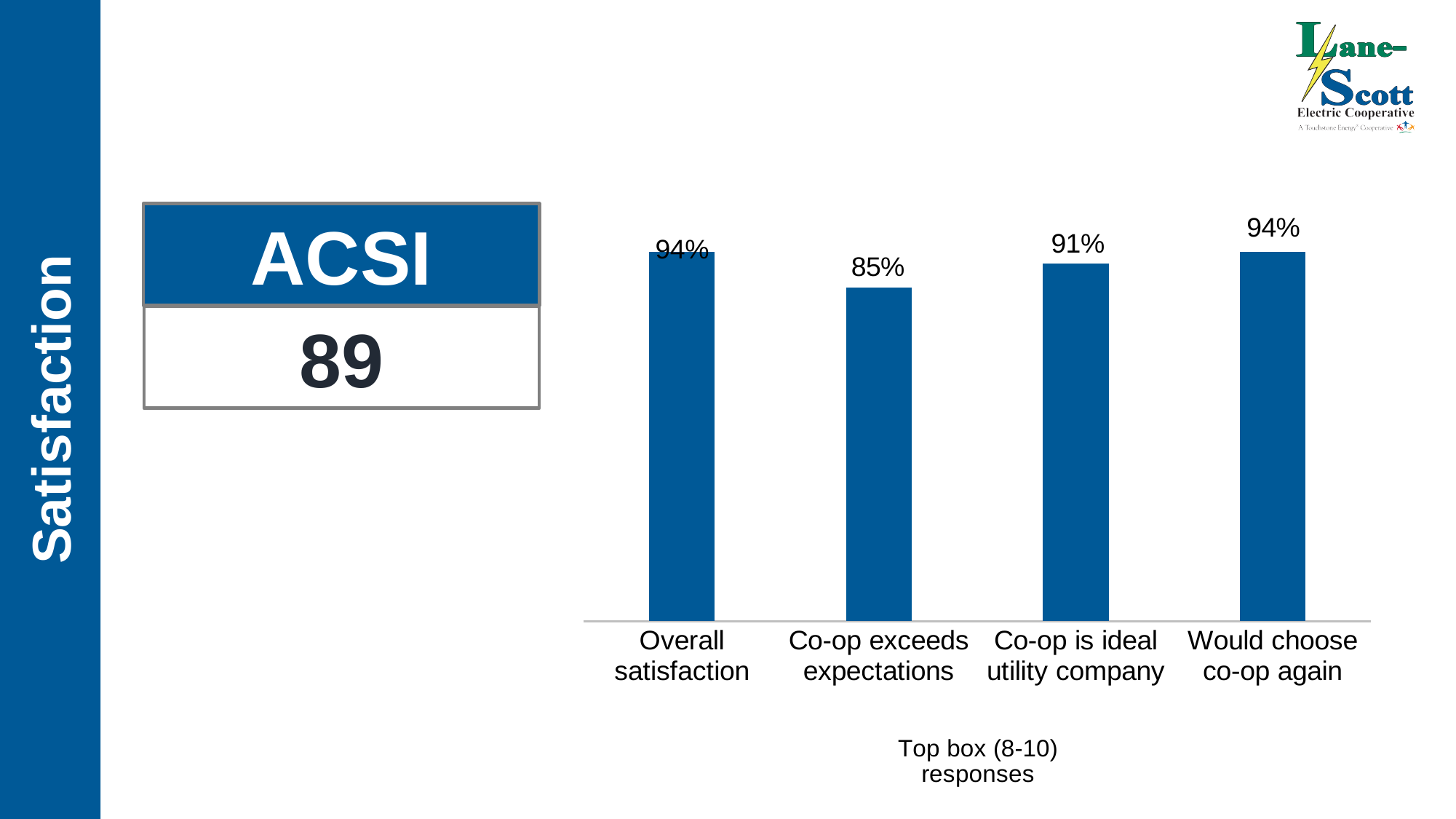
How many categories are shown in the chart? 4 What is the value for Overall satisfaction? 94% Which is larger, Co-op is ideal utility company or Co-op exceeds expectations? Co-op is ideal utility company What kind of chart is shown? Bar chart What is the difference between Overall satisfaction and Co-op exceeds expectations? 9% What is the value for Co-op exceeds expectations? 85% Which category has the lowest value? Co-op exceeds expectations What is the difference between Co-op is ideal utility company and Co-op exceeds expectations? 6% What is the value for Would choose co-op again? 94% What note appears below the chart's category labels? Top box (8-10) responses What is the value for Co-op is ideal utility company? 91% What ACSI score is shown on the slide? 89